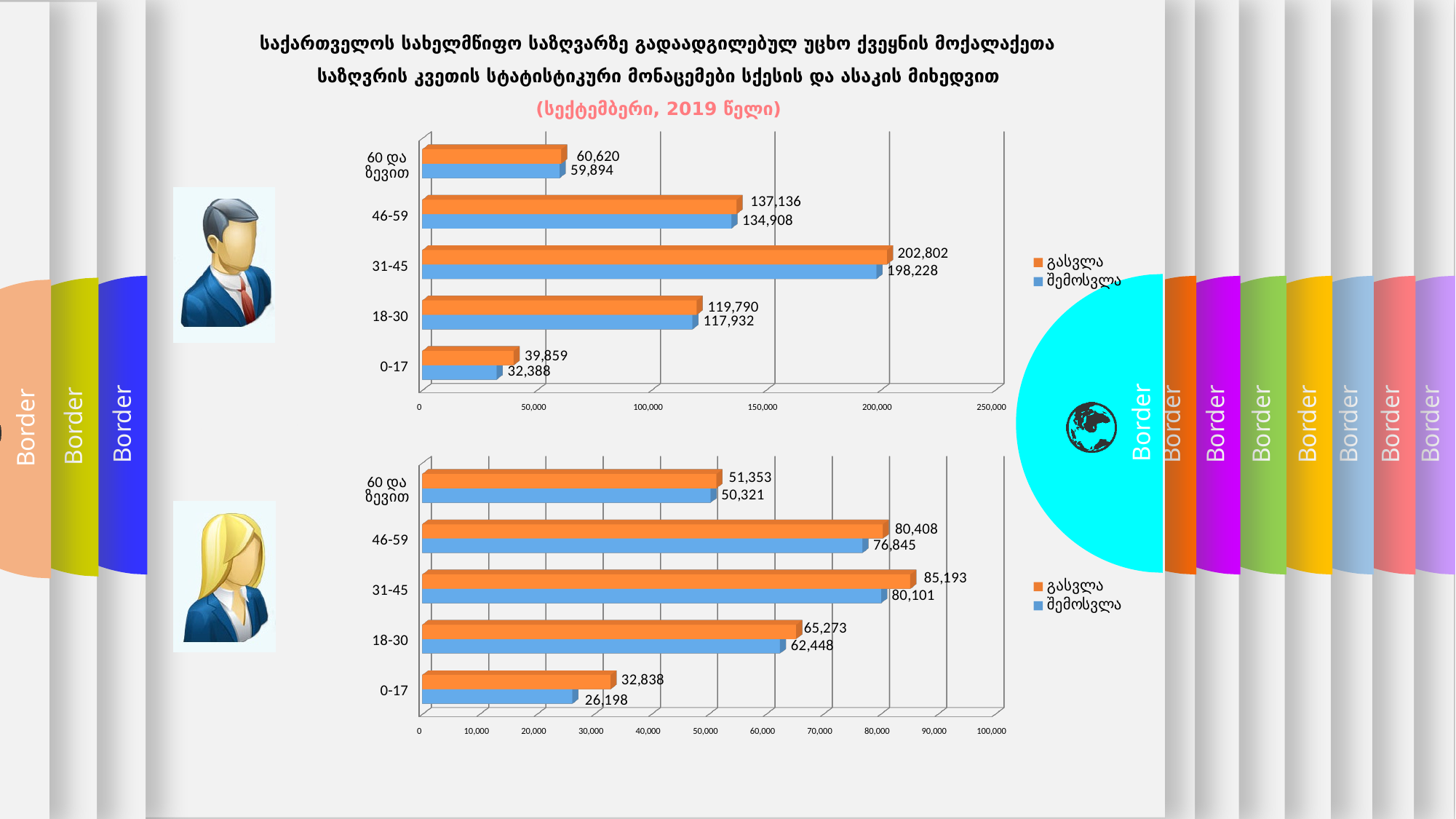
On the top chart, what is the difference between the გასვლა and შემოსვლა values for the 46-59 age group? 2,228 On the top chart, which age group has the highest გასვლა value? 31-45 On the bottom chart, what is the გასვლა value for the 18-30 age group? 65,273 On the bottom chart, which is larger: the გასვლა value for 46-59 or the შემოსვლა value for 31-45? გასვლა for 46-59 On the top chart, what is the შემოსვლა value for the 0-17 age group? 32,388 On the bottom chart, which age group has the lowest შემოსვლა value? 0-17 How many series does the legend of the bottom chart list? 2 On the top chart, what is the გასვლა value for the 31-45 age group? 202,802 How many age groups are shown on the top chart? 5 On the bottom chart, what is the difference between the გასვლა values for 31-45 and 18-30? 19,920 What type of chart is the top chart? Bar chart On the bottom chart, what is the შემოსვლა value for the 46-59 age group? 76,845